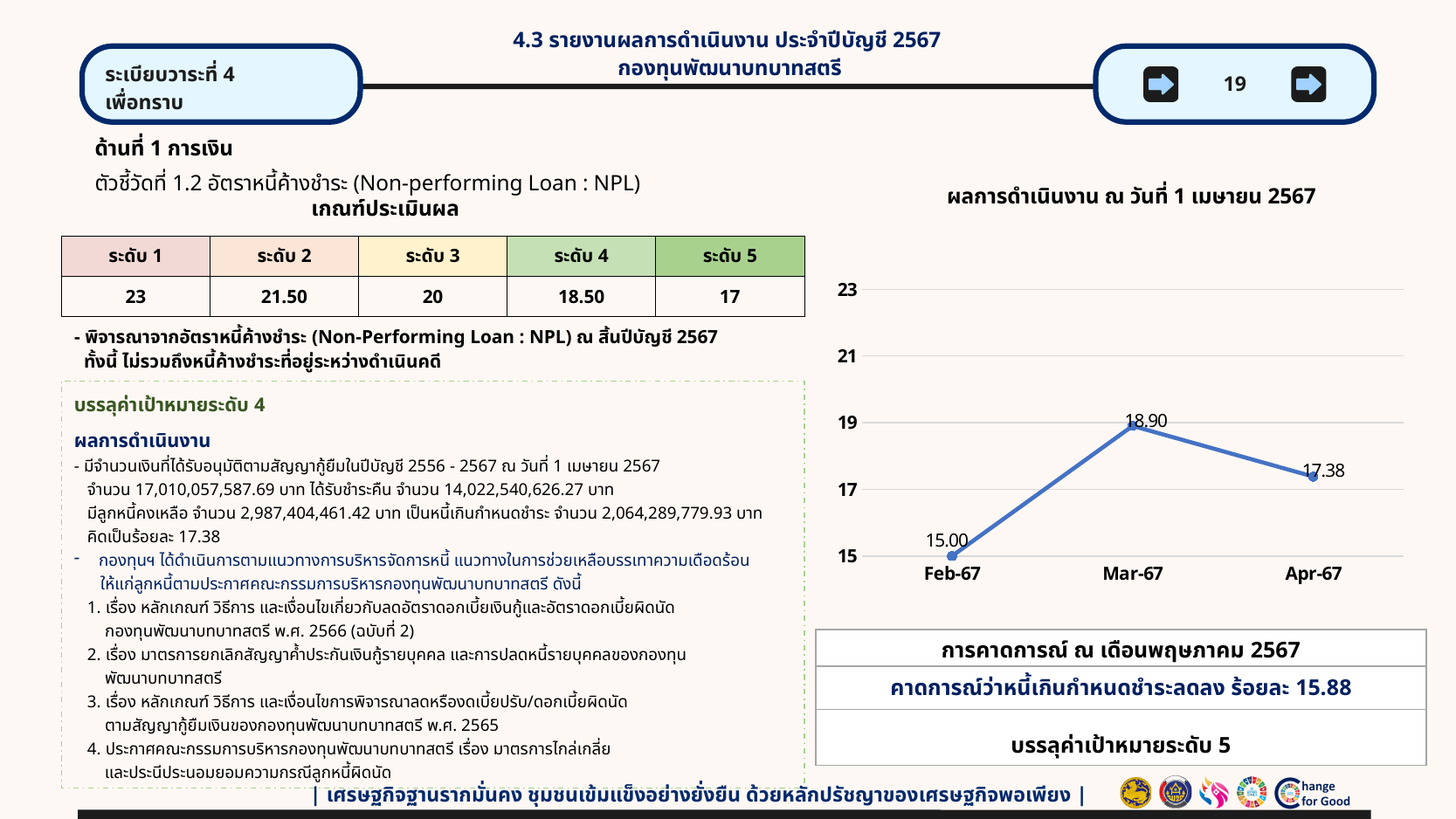
What kind of chart is shown on the slide? line chart Does the line chart rise or fall from Mar-67 to Apr-67? fall Which is larger on the line chart, the value for Apr-67 or the value for Feb-67? Apr-67 How many data points are plotted on the line chart? 3 What is the value for Apr-67 on the line chart? 17.38 What is the difference between the values for Mar-67 and Apr-67 on the line chart? 1.52 Which month has the highest value on the line chart? Mar-67 What is the difference between the values for Mar-67 and Feb-67 on the line chart? 3.90 Is the value for Apr-67 on the line chart greater or less than 19? less What is the value for Mar-67 on the line chart? 18.90 What is the value for Feb-67 on the line chart? 15.00 Which month has the lowest value on the line chart? Feb-67